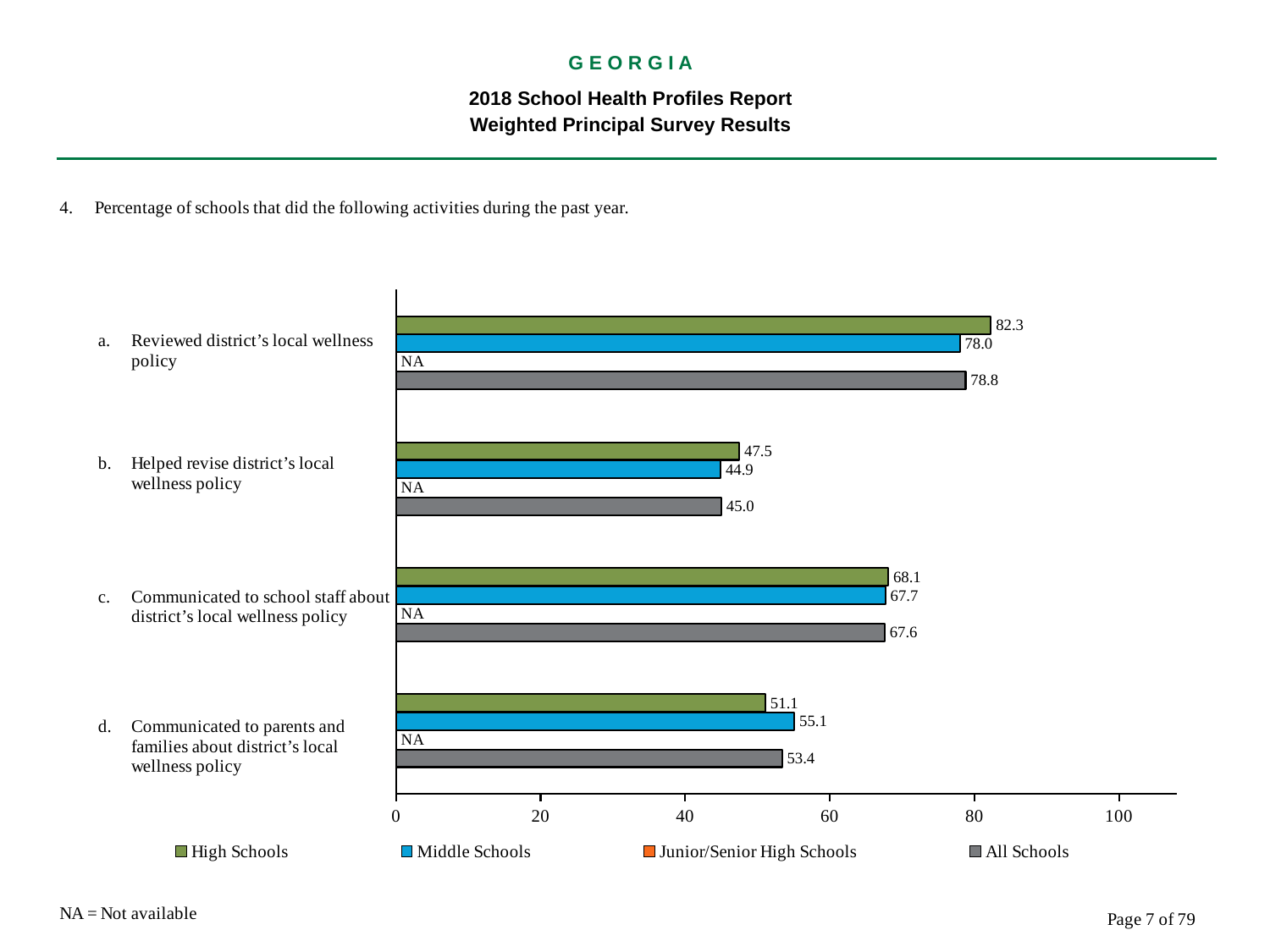
How many activities (categories) are shown on the chart? 4 Which activity has the highest value for High Schools? Reviewed district's local wellness policy What kind of chart is shown on the slide? bar chart What value is shown for Junior/Senior High Schools for 'Communicated to school staff about district's local wellness policy'? NA Is the All Schools value for 'Communicated to school staff about district's local wellness policy' greater or less than 60? greater What is the value for Middle Schools for 'Communicated to parents and families about district's local wellness policy'? 55.1 For 'Communicated to parents and families about district's local wellness policy', which is larger: the High Schools value or the Middle Schools value? Middle Schools What is the value for All Schools for 'Helped revise district's local wellness policy'? 45.0 Which activity has the lowest value for Middle Schools? Helped revise district's local wellness policy What is the difference between the High Schools and Middle Schools values for 'Reviewed district's local wellness policy'? 4.3 How many series does the legend list? 4 What is the value for High Schools for 'Reviewed district's local wellness policy'? 82.3